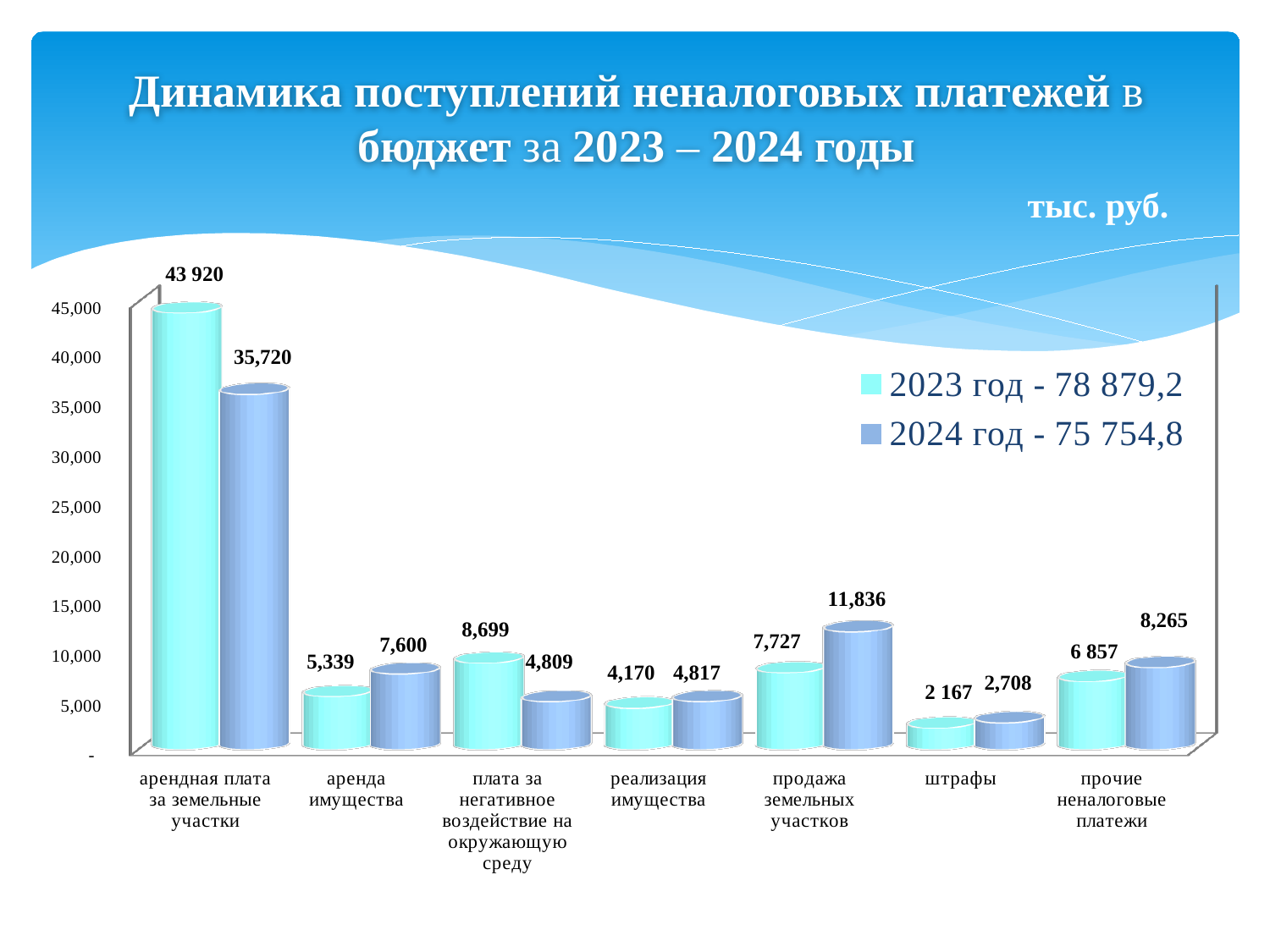
Which category has the highest 2024 год value? арендная плата за земельные участки What is the 2023 год value for штрафы? 2 167 What is the 2024 год value for прочие неналоговые платежи? 8,265 What is the difference between the 2024 год and 2023 год values for аренда имущества? 2,261 For плата за негативное воздействие на окружающую среду, which is larger: the 2023 год value or the 2024 год value? 2023 год What is the 2023 год value for арендная плата за земельные участки? 43 920 How many series does the legend list? 2 What is the 2024 год value for продажа земельных участков? 11,836 What total is shown in the legend entry for 2023 год? 78 879,2 How many categories are shown on the x axis? 7 What type of chart is shown on the slide? bar chart Which category has the lowest 2023 год value? штрафы